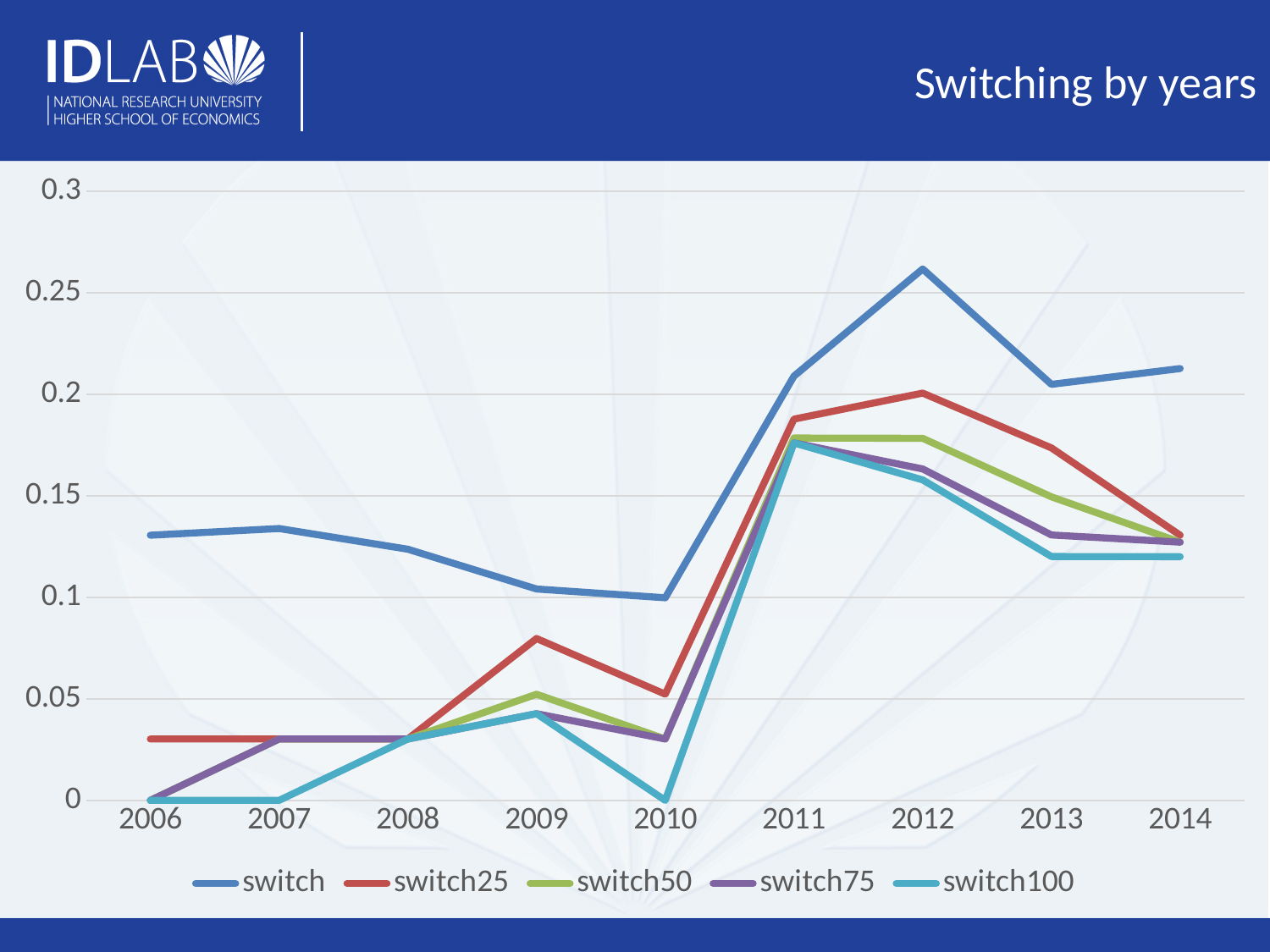
How many years are shown on the x axis? 9 Is the value of 'switch25' in 2009 greater or less than 0.05? greater In which year does the 'switch' series reach its highest value? 2012 Is the value of 'switch100' in 2013 greater or less than 0.15? less How many series does the legend list? 5 In 2011, which series has the larger value, 'switch' or 'switch25'? switch What kind of chart is shown on the slide? line chart Does the 'switch' series rise or fall from 2007 to 2010? fall Is the value of 'switch' in 2012 greater or less than 0.25? greater What is the title of the chart? Switching by years What is the value of 'switch100' in 2010? 0 In which year is the 'switch' series at its lowest value? 2010